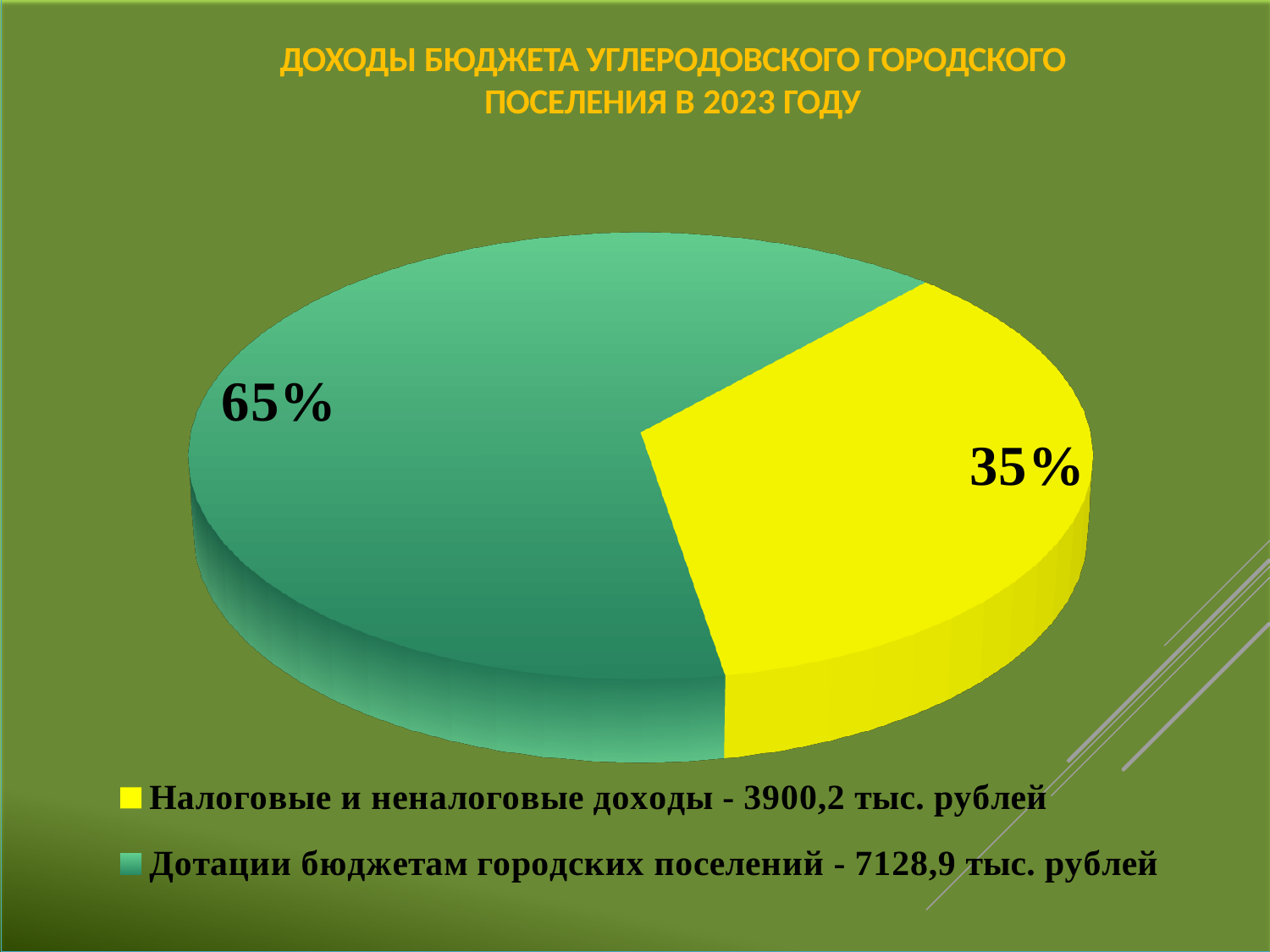
Which category has the largest slice of the pie? Дотации бюджетам городских поселений What amount in thousand rubles does the legend give for Дотации бюджетам городских поселений? 7128,9 тыс. рублей What share of the pie does the slice for Налоговые и неналоговые доходы represent? 35% What colour is the slice for Налоговые и неналоговые доходы? Yellow Which is larger: the slice for Налоговые и неналоговые доходы or the slice for Дотации бюджетам городских поселений? Дотации бюджетам городских поселений What amount in thousand rubles does the legend give for Налоговые и неналоговые доходы? 3900,2 тыс. рублей How many slices does the pie chart have? 2 What share of the pie does the slice for Дотации бюджетам городских поселений represent? 65% Which category has the smallest slice of the pie? Налоговые и неналоговые доходы What kind of chart is shown on the slide? Pie chart What is the difference in percentage points between the Дотации бюджетам городских поселений slice and the Налоговые и неналоговые доходы slice? 30 percentage points What is the title of the chart on the slide? ДОХОДЫ БЮДЖЕТА УГЛЕРОДОВСКОГО ГОРОДСКОГО ПОСЕЛЕНИЯ В 2023 ГОДУ